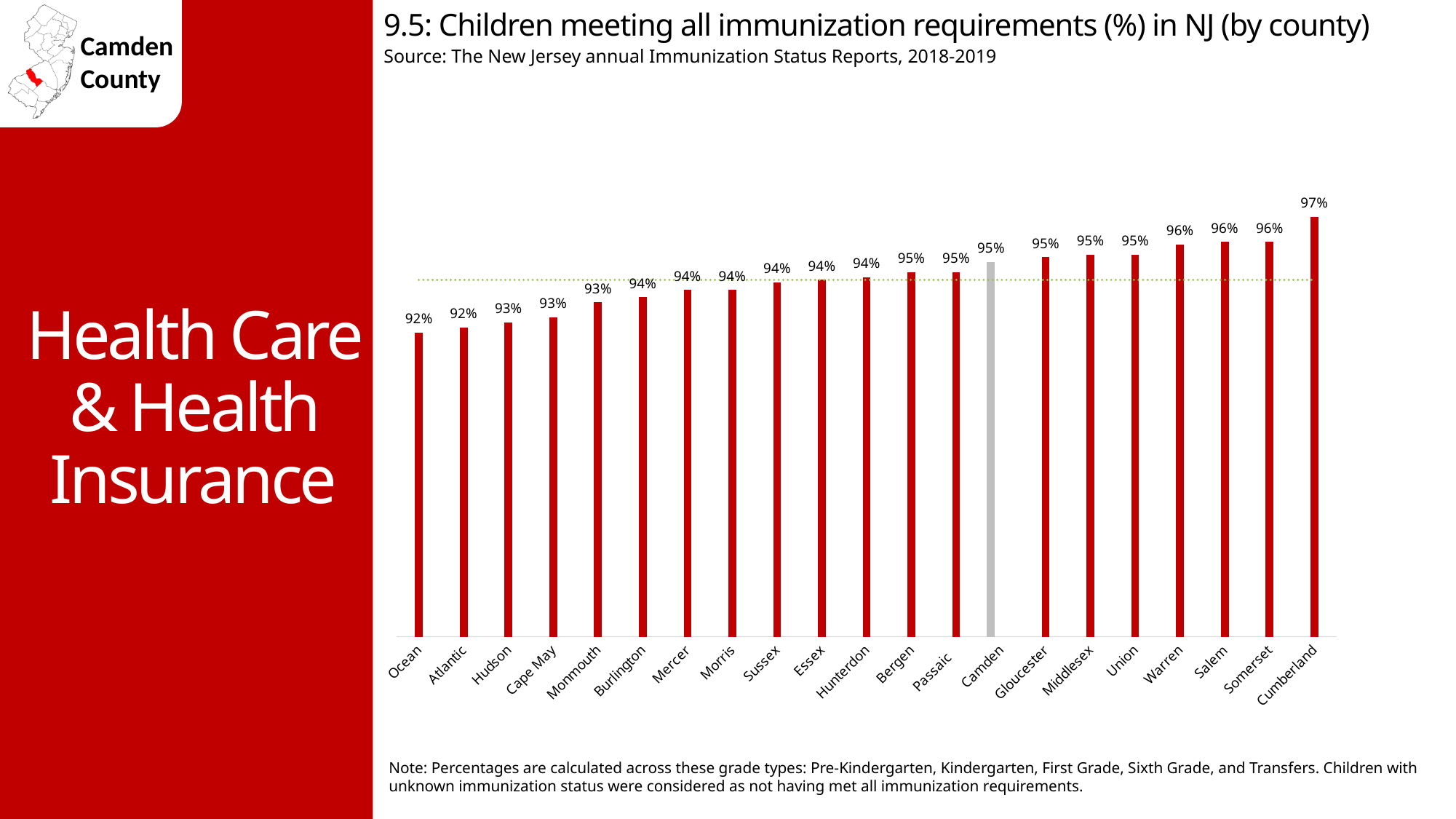
What percentage is shown for Warren County? 96% What kind of chart is used on this slide? Bar chart What is the difference in percentage points between Cumberland County and Ocean County? 5 percentage points Which county has the highest percentage of children meeting all immunization requirements? Cumberland What percentage is shown for Ocean County? 92% Do the values generally rise or fall moving from left to right along the x axis? Rise What is the value shown for Monmouth County? 93% What percentage of children in Camden County met all immunization requirements? 95% How many counties are shown on the chart? 21 What is the value shown for Cumberland County? 97% Which county has a higher value, Hudson or Salem? Salem Which county's bar is coloured grey instead of red? Camden